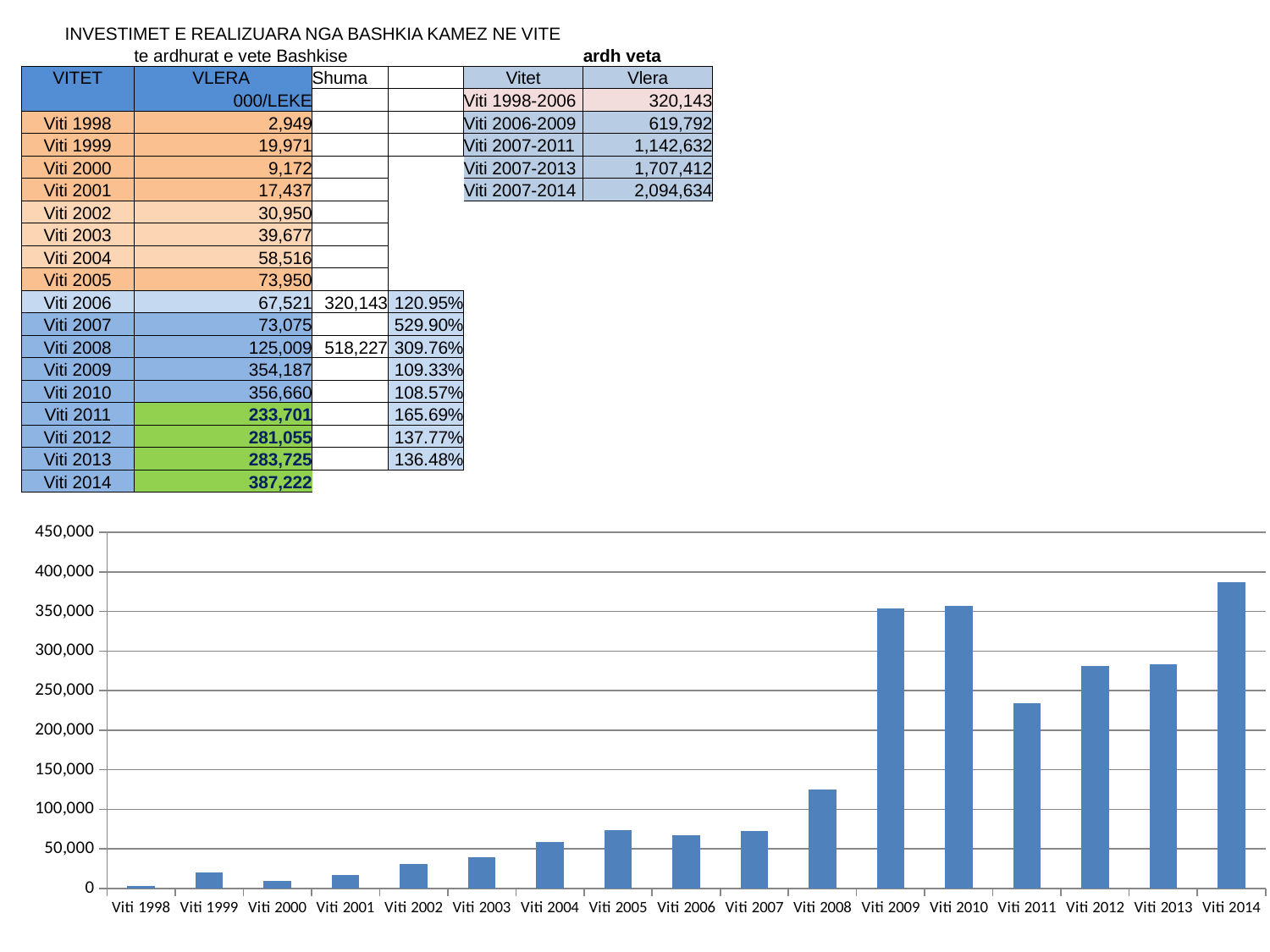
Which bar is taller, Viti 2011 or Viti 2012? Viti 2012 Is the bar for Viti 2011 greater or less than 250,000? less Do the bars rise or fall from Viti 2011 to Viti 2014? rise According to the table, what is the value (VLERA) for Viti 2014? 387,222 Is the bar for Viti 2005 greater or less than 100,000? less Which year has the tallest bar in the chart? Viti 2014 What kind of chart is shown at the bottom of the slide? bar chart Which bar is taller, Viti 2007 or Viti 2008? Viti 2008 Using the table values, what is the difference between Viti 2014 and Viti 2013? 103,497 Which year has the shortest bar in the chart? Viti 1998 Is the bar for Viti 2009 greater or less than 300,000? greater How many years (categories) are plotted on the x axis of the bar chart? 17